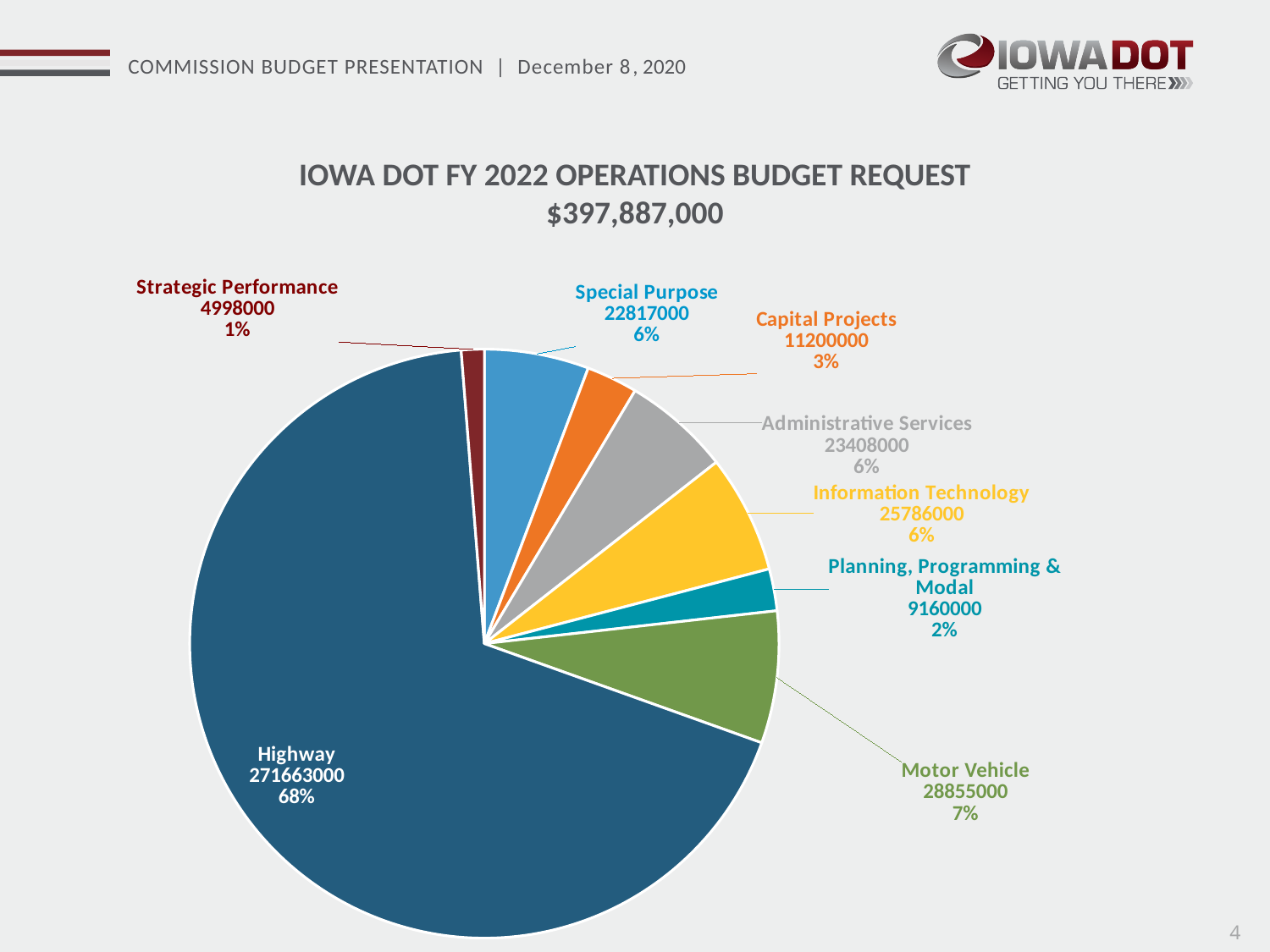
Which category has the smallest slice? Strategic Performance What is the difference between the values for Information Technology and Administrative Services? 2378000 Which is larger, the value for Special Purpose or the value for Capital Projects? Special Purpose What share of the pie does Capital Projects represent? 3% Which category has the largest slice? Highway What is the value for Planning, Programming & Modal? 9160000 What kind of chart is shown on the slide? Pie chart What is the value for Motor Vehicle? 28855000 How many categories are shown in the pie chart? 8 What is the title of the chart? IOWA DOT FY 2022 OPERATIONS BUDGET REQUEST $397,887,000 What share of the pie does Highway represent? 68% What is the value for Highway? 271663000